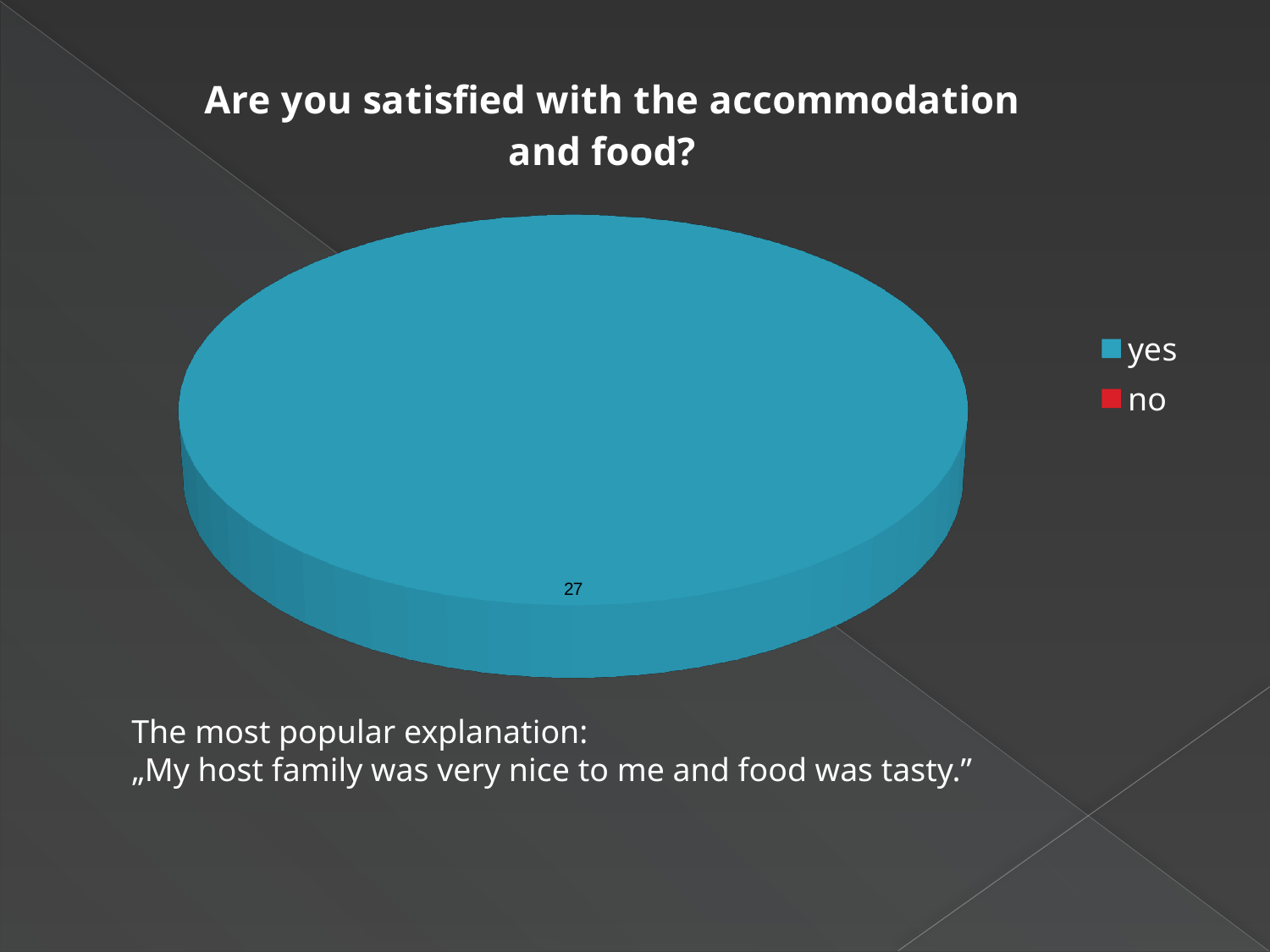
Which is larger in the pie chart, "yes" or "no"? yes What is the title of the pie chart? Are you satisfied with the accommodation and food? What value is shown for the "yes" slice of the pie chart? 27 How many entries does the legend of the pie chart list? 2 Which category has the largest slice in the pie chart? yes What colour represents "yes" in the pie chart legend? blue What kind of chart is shown on the slide? pie chart Which category has the smallest slice in the pie chart? no